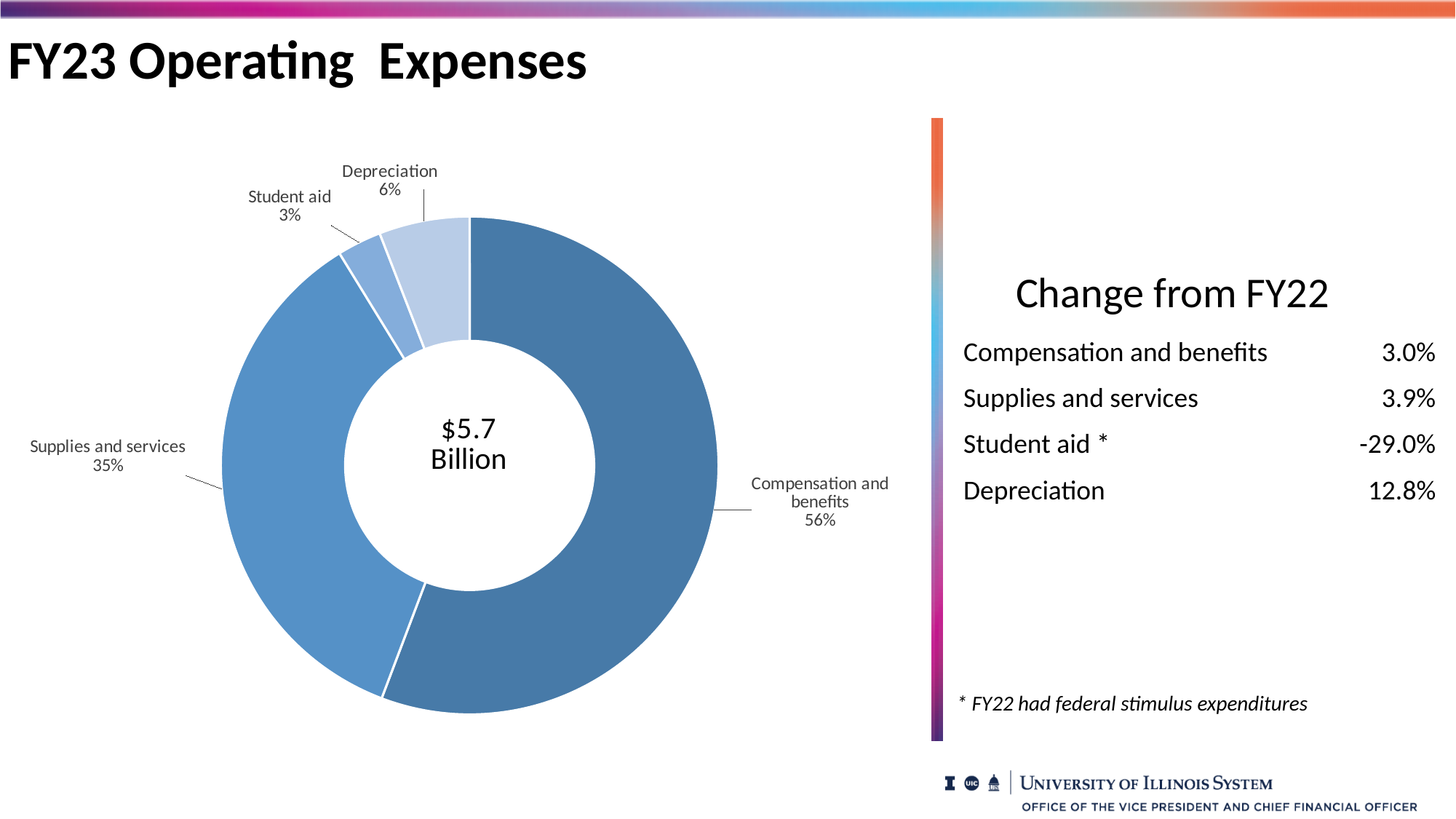
What is the title of the slide containing the operating expenses chart? FY23 Operating Expenses Which has a larger share of FY23 operating expenses, Depreciation or Student aid? Depreciation How many percentage points larger is the Compensation and benefits share than the Supplies and services share? 21 What share of FY23 operating expenses is Depreciation? 6% How many categories are shown in the FY23 operating expenses chart? 4 What kind of chart is used to show FY23 operating expenses? Pie chart (donut) Which category has the smallest share of FY23 operating expenses? Student aid Which category has the largest share of FY23 operating expenses? Compensation and benefits What share of FY23 operating expenses is Student aid? 3% What share of FY23 operating expenses is Compensation and benefits? 56% What share of FY23 operating expenses is Supplies and services? 35% What total amount is shown in the centre of the FY23 operating expenses chart? $5.7 Billion